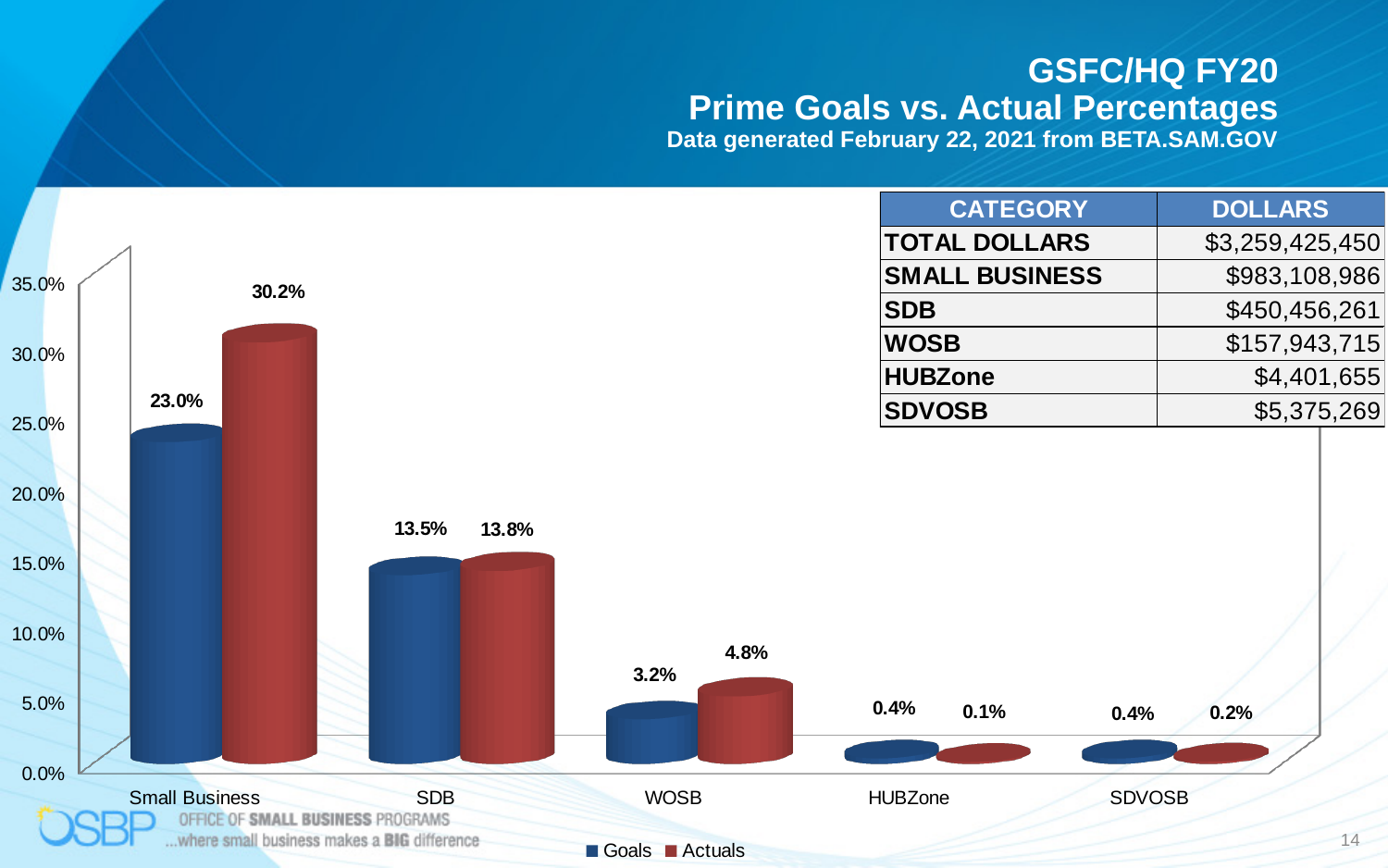
Which is larger for WOSB, the Goals value or the Actuals value? Actuals What kind of chart is shown on the slide? Bar chart What is the difference between the Actuals and Goals values for Small Business? 7.2% What is the Goals value for SDB? 13.5% What is the Goals value for WOSB? 3.2% Is the Goals value for Small Business greater or less than 20.0%? greater What is the Actuals value for HUBZone? 0.1% Which category has the lowest Actuals value? HUBZone What is the Actuals value for Small Business? 30.2% How many series does the legend list? 2 Which category has the highest Actuals value? Small Business How many categories are shown on the x axis? 5